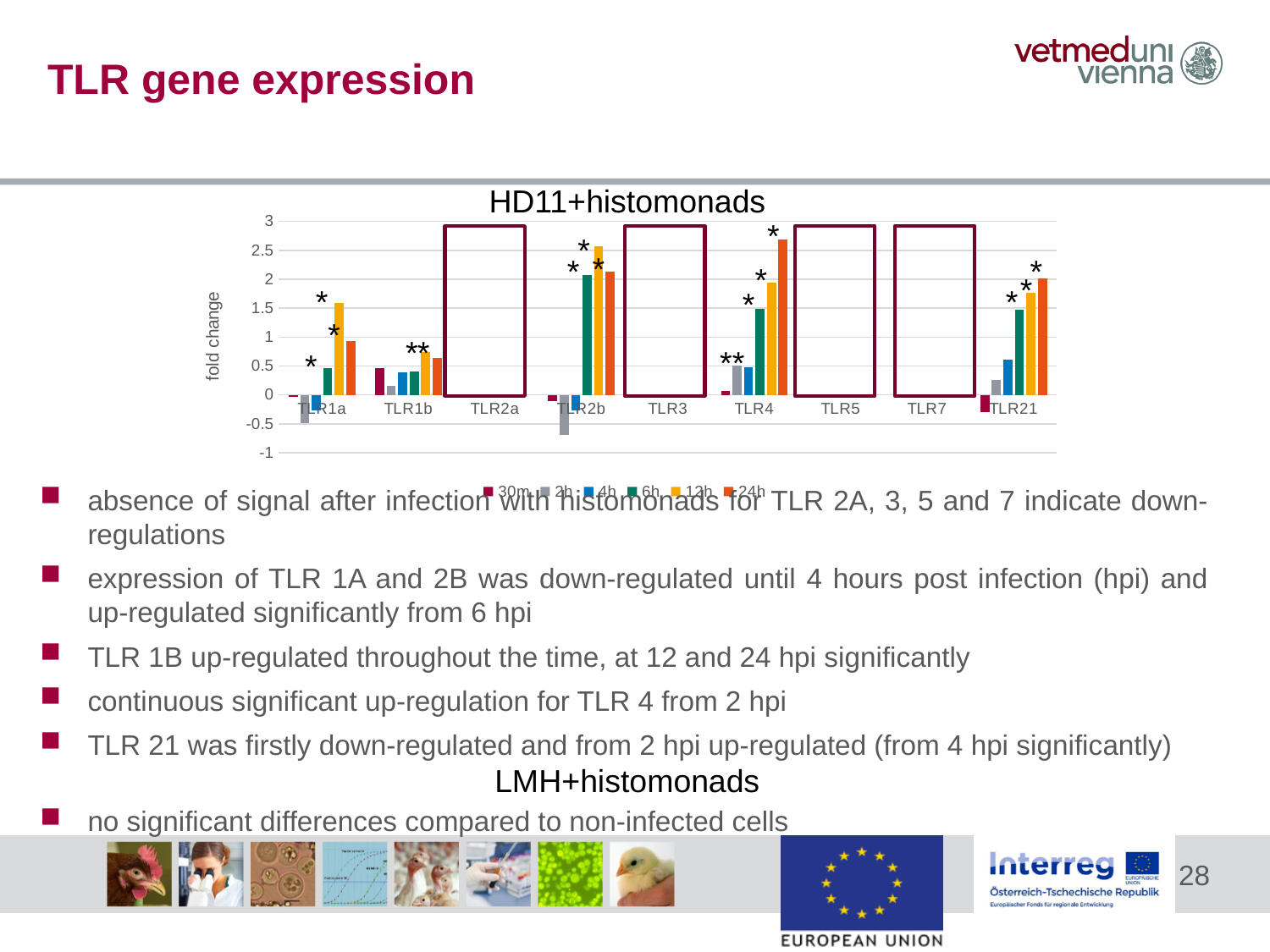
What is the label of the y axis of the HD11+histomonads chart? fold change In the HD11+histomonads chart, is the 12h value for TLR1a greater or less than 1? greater In the HD11+histomonads chart, is the 2h value for TLR2b greater or less than -0.5? less In the HD11+histomonads chart, is the 24h value for TLR4 greater or less than 2.5? greater In the HD11+histomonads chart, which TLR category has the highest 24h bar? TLR4 In the HD11+histomonads chart, which is larger: the 24h value for TLR4 or the 24h value for TLR1a? TLR4 What kind of chart is shown under the title HD11+histomonads? bar chart In the HD11+histomonads chart, which is larger: the 12h value for TLR2b or the 12h value for TLR1b? TLR2b What is the title of the bar chart on the slide? HD11+histomonads How many TLR categories are shown on the x axis of the HD11+histomonads chart? 9 How many series does the legend of the HD11+histomonads chart list? 6